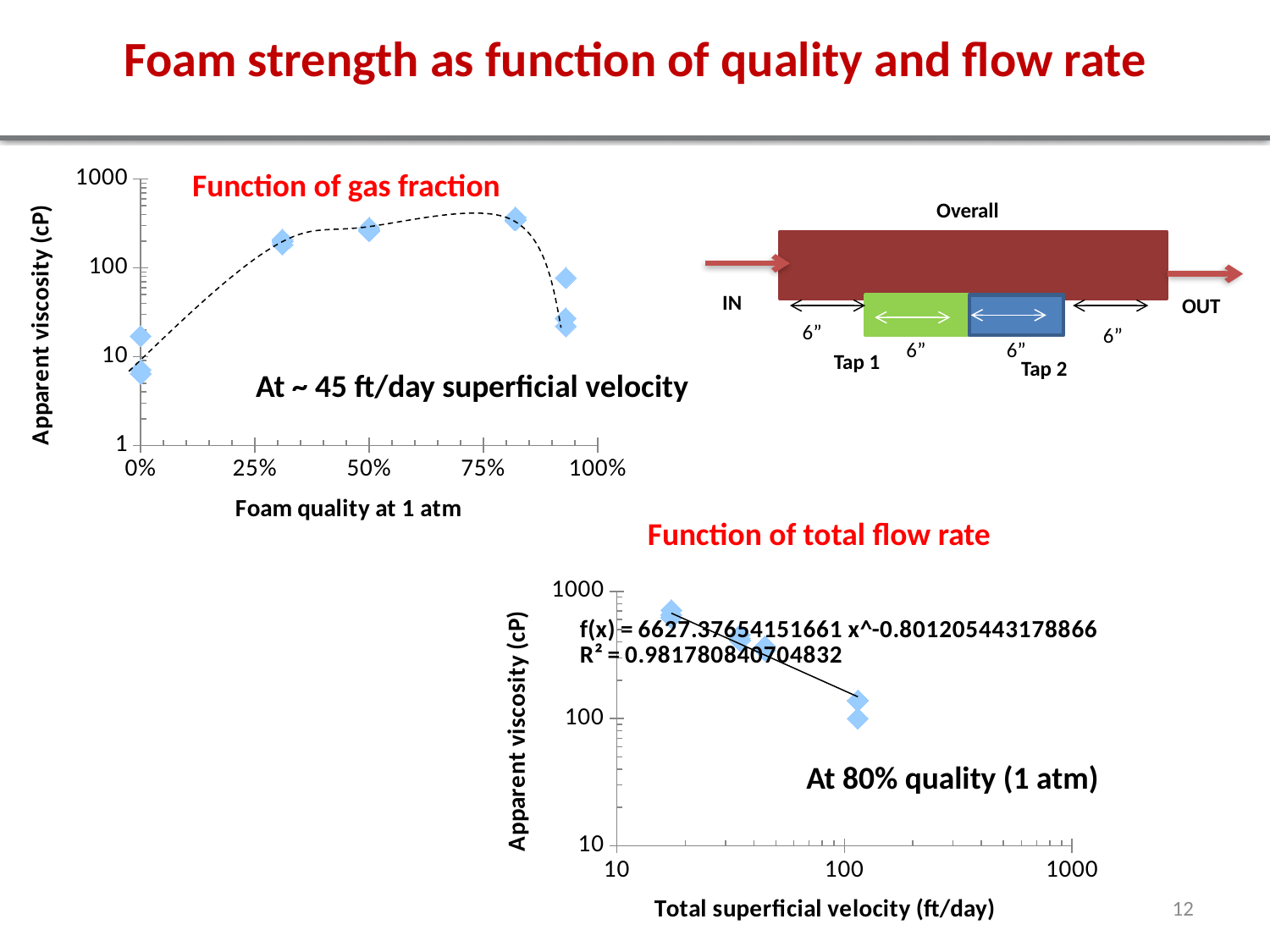
What is the x-axis title of the 'Function of total flow rate' chart? Total superficial velocity (ft/day) In the 'Function of gas fraction' chart, is the apparent viscosity at about 80% foam quality greater or less than 100 cP? greater What kind of chart is the 'Function of gas fraction' chart? scatter chart What kind of chart is the 'Function of total flow rate' chart? scatter chart In the 'Function of total flow rate' chart, does apparent viscosity rise or fall as total superficial velocity increases? fall In the 'Function of gas fraction' chart, is the apparent viscosity at 50% foam quality greater or less than 100 cP? greater In the 'Function of gas fraction' chart, does apparent viscosity rise or fall as foam quality increases from 0% to 50%? rise In the 'Function of gas fraction' chart, are the apparent viscosity values at 0% foam quality greater or less than 100 cP? less What R² value is printed on the 'Function of total flow rate' chart? 0.981780840704832 What is the x-axis title of the 'Function of gas fraction' chart? Foam quality at 1 atm